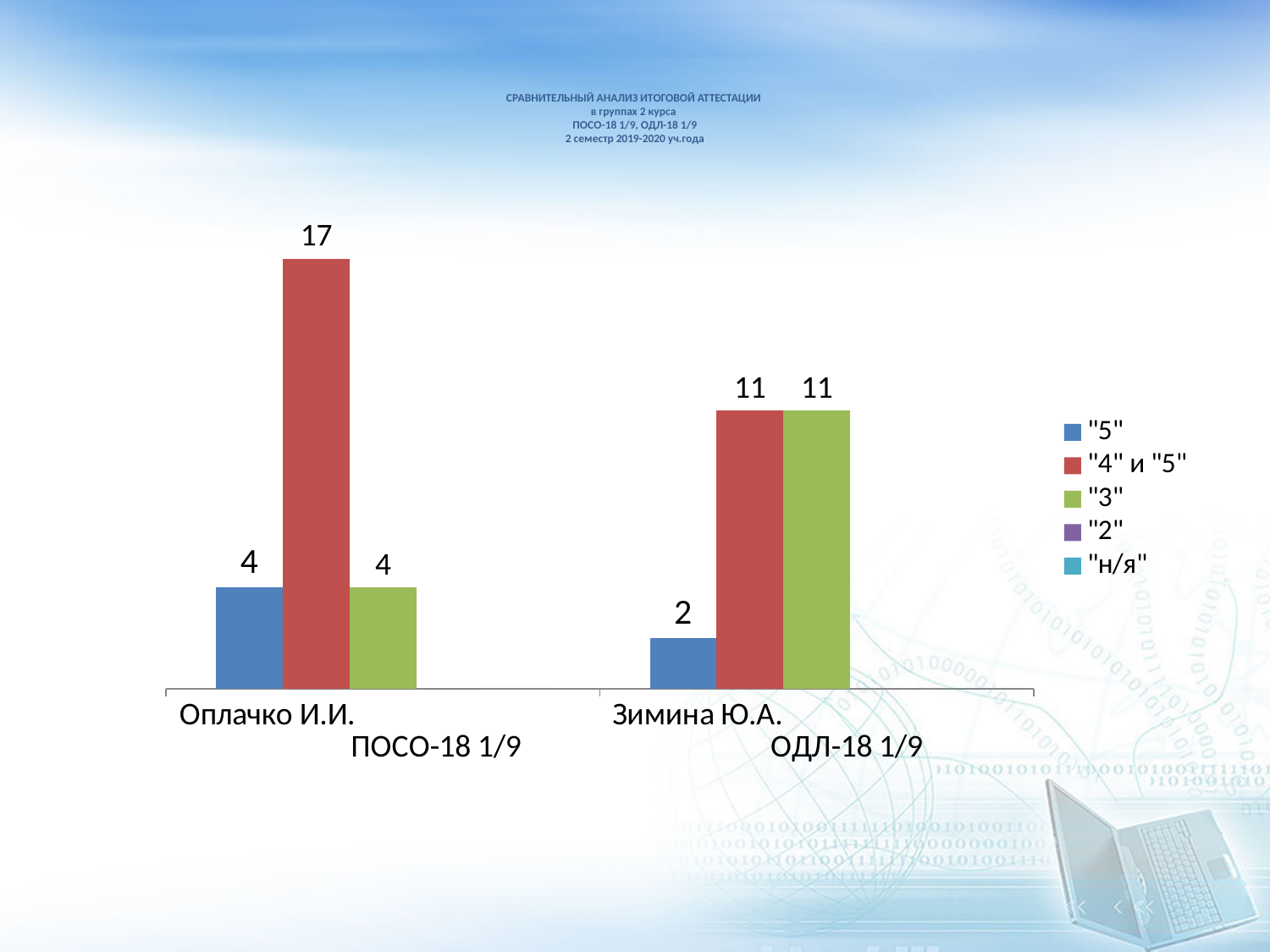
How many series does the legend list? 5 What is the value of the "5" series for Оплачко И.И. ПОСО-18 1/9? 4 What is the value of the "5" series for Зимина Ю.А. ОДЛ-18 1/9? 2 What is the value of the "4" и "5" series for Оплачко И.И. ПОСО-18 1/9? 17 What is the difference between the "4" и "5" values for Оплачко И.И. ПОСО-18 1/9 and Зимина Ю.А. ОДЛ-18 1/9? 6 What colour represents the "3" series in the legend? green What is the value of the "3" series for Зимина Ю.А. ОДЛ-18 1/9? 11 What kind of chart is shown on the slide? bar chart How many categories are shown on the x axis? 2 Which category has the highest value in the "4" и "5" series? Оплачко И.И. ПОСО-18 1/9 Which category has the lowest value in the "5" series? Зимина Ю.А. ОДЛ-18 1/9 Which is larger: the "3" value for Оплачко И.И. ПОСО-18 1/9 or the "3" value for Зимина Ю.А. ОДЛ-18 1/9? Зимина Ю.А. ОДЛ-18 1/9